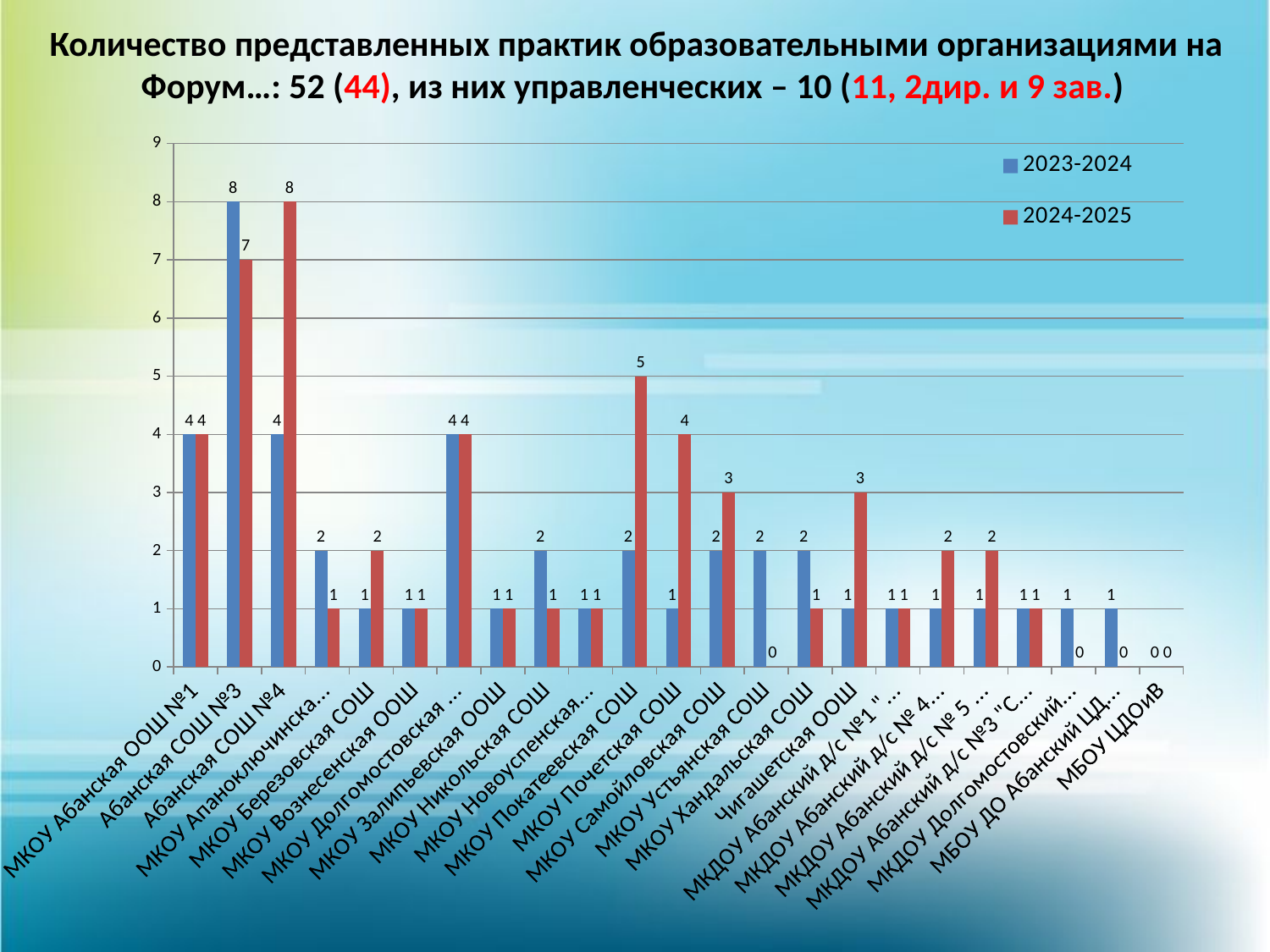
How many series does the legend list? 2 What is the 2024-2025 value for МКОУ Почетская СОШ? 4 What is the 2024-2025 value for МКОУ Покатеевская СОШ? 5 For МКОУ Самойловская СОШ, which series has the larger value, 2023-2024 or 2024-2025? 2024-2025 Which category has the highest 2023-2024 value? Абанская СОШ №3 What type of chart is shown on the slide? bar chart What is the difference between the 2024-2025 and 2023-2024 values for Абанская СОШ №4? 4 Which category has the highest 2024-2025 value? Абанская СОШ №4 Which series is shown in red in the legend? 2024-2025 What is the 2023-2024 value for Абанская СОШ №3? 8 For МКОУ Устьянская СОШ, which series has the larger value, 2023-2024 or 2024-2025? 2023-2024 What is the 2024-2025 value for Чигашетская ООШ? 3